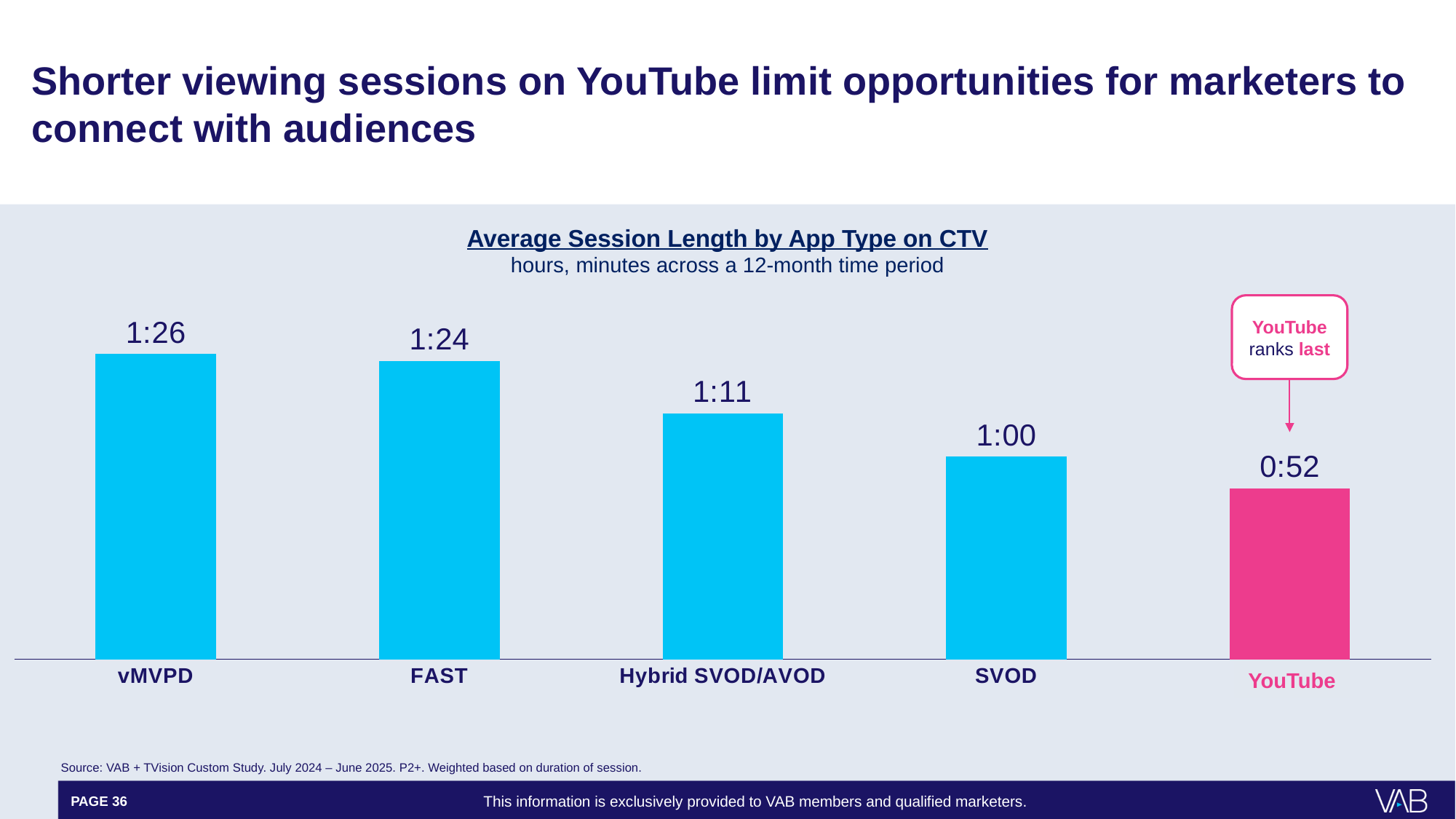
How many app types are shown in the chart? 5 How much longer is the average session on FAST than on SVOD? 24 minutes How much longer is the average session on vMVPD than on YouTube? 34 minutes What is the average session length for vMVPD? 1:26 Which has a longer average session length, Hybrid SVOD/AVOD or SVOD? Hybrid SVOD/AVOD Which app type has the shortest average session length? YouTube What is the average session length for YouTube? 0:52 What kind of chart is shown on the slide? Bar chart What is the average session length for Hybrid SVOD/AVOD? 1:11 What is the average session length for SVOD? 1:00 Which app type has the longest average session length? vMVPD Do the average session lengths rise or fall from left to right across the app types? Fall